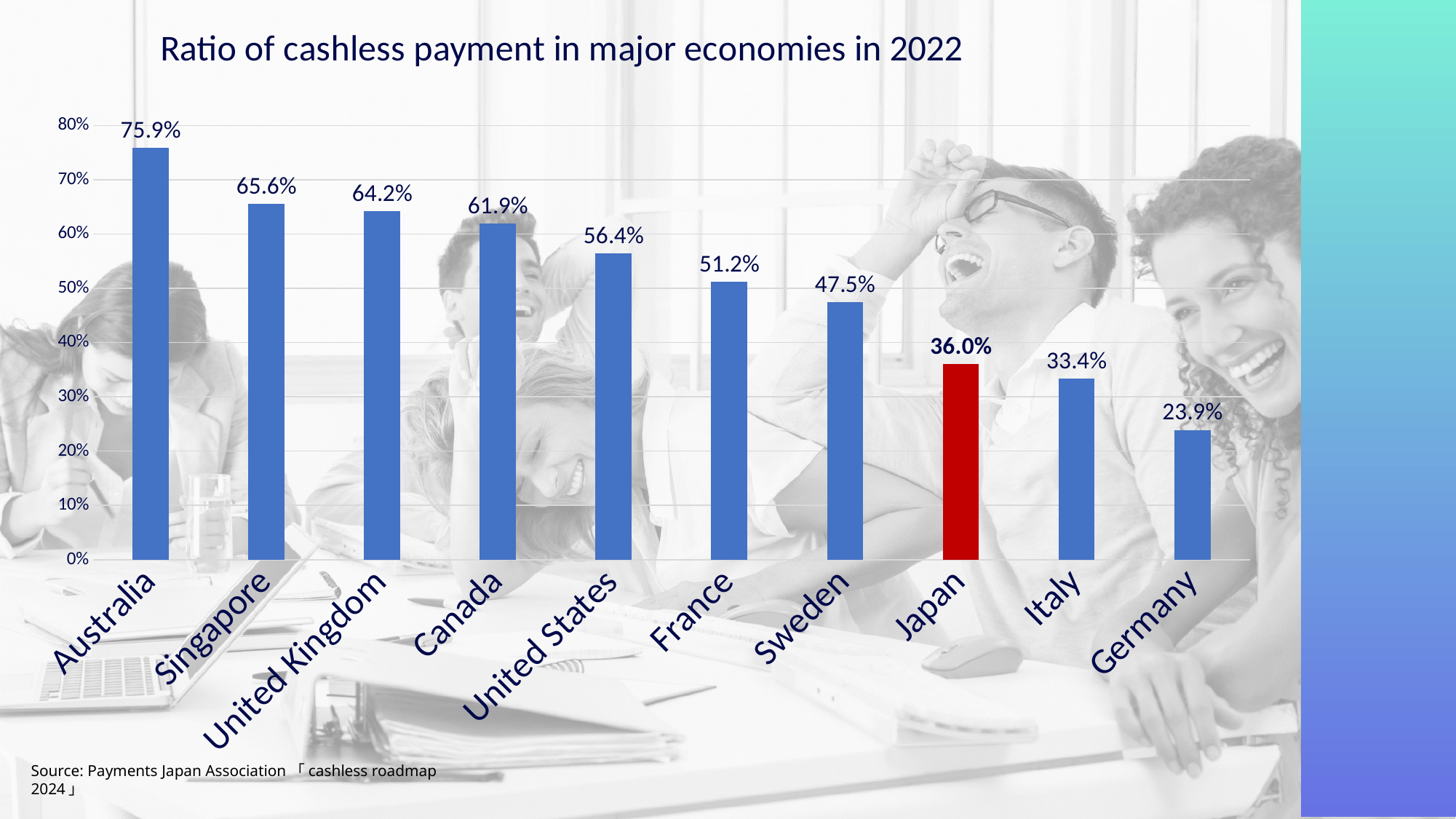
What is the ratio of cashless payment for Sweden? 47.5% What is the difference between the cashless payment ratios of Singapore and the United Kingdom? 1.4% How many countries are shown in the chart? 10 What is the difference between the cashless payment ratios of Australia and Japan? 39.9% What is the ratio of cashless payment for Japan? 36.0% Which has a higher ratio of cashless payment, France or Italy? France Which country has the lowest ratio of cashless payment? Germany Which country's bar is coloured red instead of blue? Japan What is the ratio of cashless payment for Canada? 61.9% What kind of chart is shown on the slide? Bar chart Is the value for the United States greater or less than 50%? greater Which country has the highest ratio of cashless payment? Australia